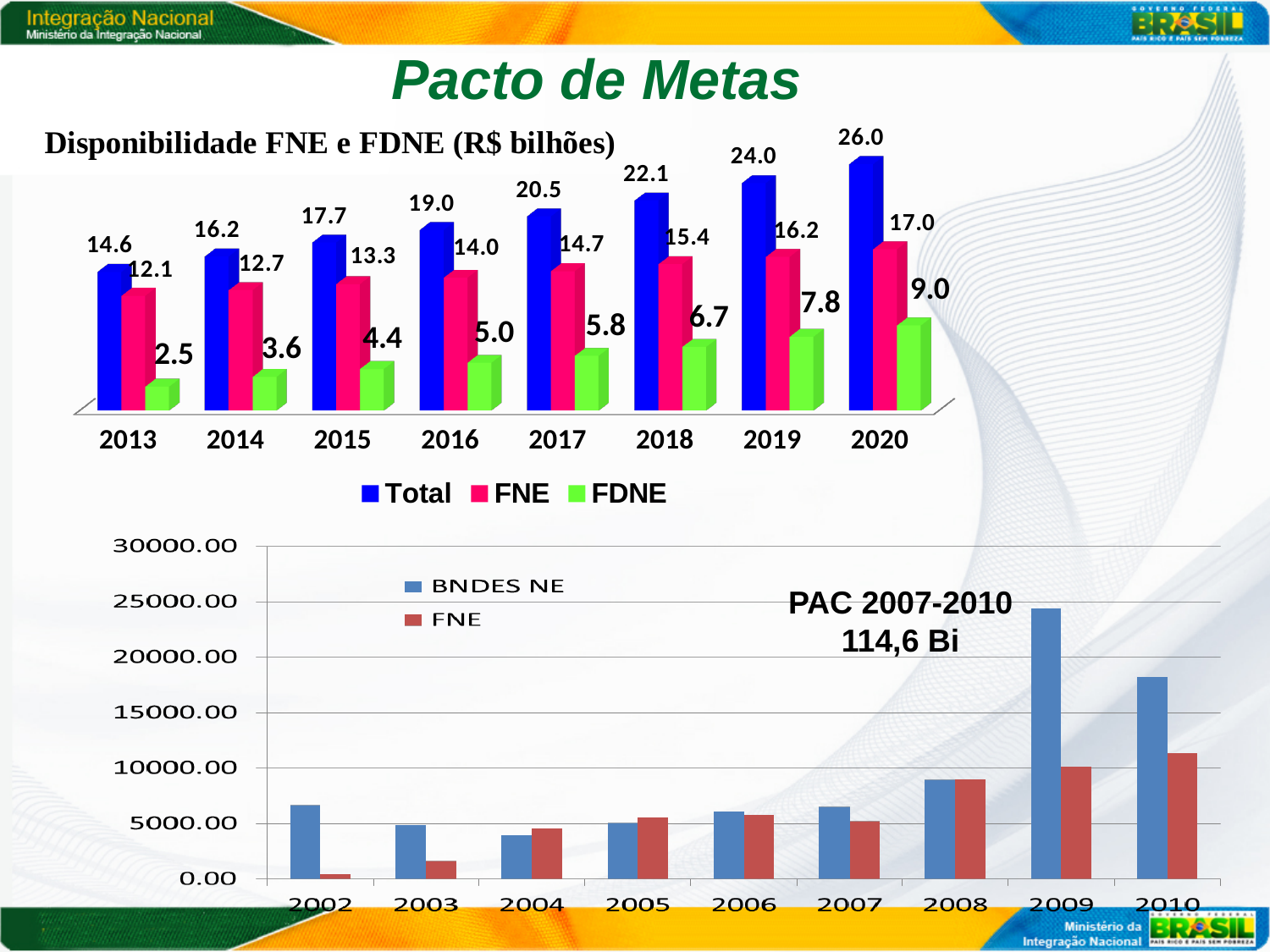
In the bottom chart, is the BNDES NE value for 2009 greater or less than 20000.00? greater In the bottom chart, which is larger for 2002, BNDES NE or FNE? BNDES NE In the bottom chart, which year has the highest BNDES NE value? 2009 In the top chart 'Disponibilidade FNE e FDNE (R$ bilhões)', what is the Total value for 2020? 26.0 In the top chart 'Disponibilidade FNE e FDNE (R$ bilhões)', what is the FDNE value for 2016? 5.0 In the top chart 'Disponibilidade FNE e FDNE (R$ bilhões)', do the FDNE values rise or fall from 2013 to 2020? rise In the top chart 'Disponibilidade FNE e FDNE (R$ bilhões)', how many years are shown on the x axis? 8 In the top chart 'Disponibilidade FNE e FDNE (R$ bilhões)', what is the FNE value for 2018? 15.4 In the top chart 'Disponibilidade FNE e FDNE (R$ bilhões)', what is the difference between the FNE values for 2020 and 2013? 4.9 In the top chart 'Disponibilidade FNE e FDNE (R$ bilhões)', which year has the lowest Total value? 2013 In the top chart 'Disponibilidade FNE e FDNE (R$ bilhões)', how many series does the legend list? 3 What kind of chart is the bottom chart on the slide? bar chart